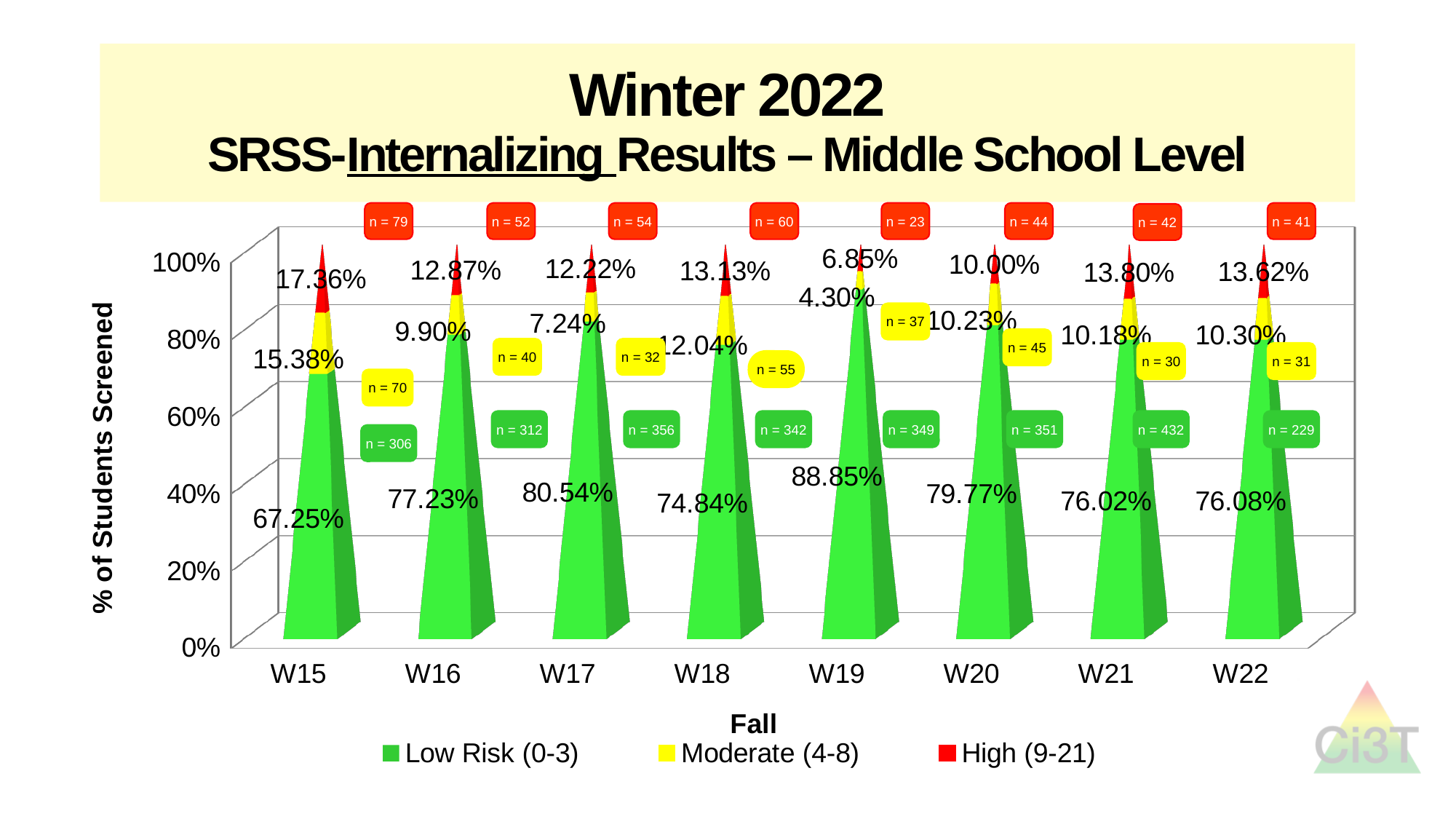
Which school has the highest Low Risk (0-3) percentage? W19 What is the Moderate (4-8) percentage for W18? 12.04% What is the n value shown for the Low Risk (0-3) group at W21? n = 432 Which school has the lowest Low Risk (0-3) percentage? W15 Which is larger, the High (9-21) percentage for W15 or for W19? W15 Which school has the highest High (9-21) percentage? W15 How many series does the legend list? 3 What percentage of students screened at W15 were in the Low Risk (0-3) category? 67.25% How many schools are shown on the x axis? 8 What kind of chart is shown on the slide? Stacked bar chart What is the difference between the Low Risk (0-3) percentages for W19 and W15? 21.60% What is the High (9-21) percentage for W19? 6.85%